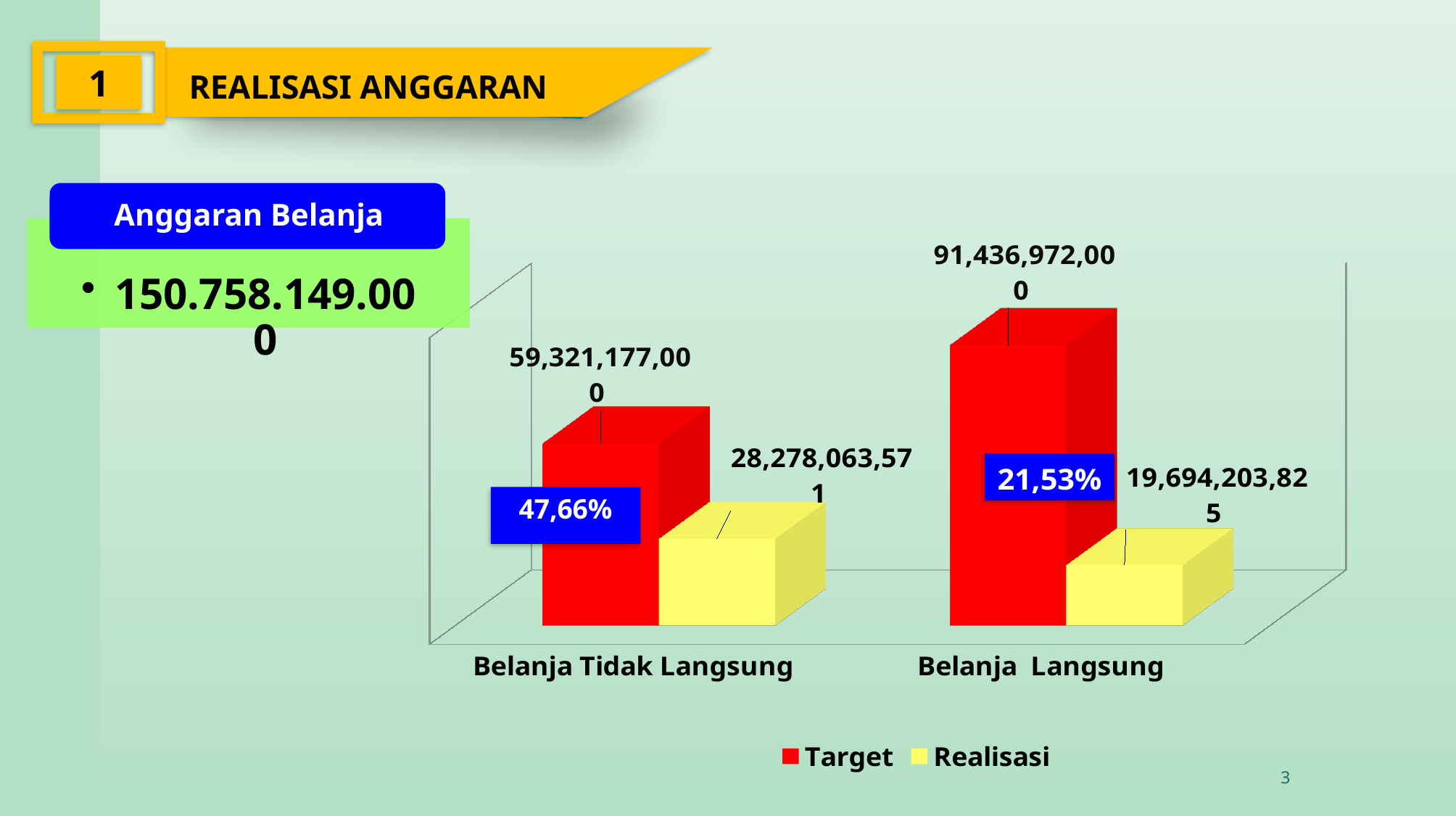
Which is larger: the Realisasi value for Belanja Tidak Langsung or the Realisasi value for Belanja Langsung? Belanja Tidak Langsung How many categories are shown on the x axis of the chart? 2 Which category has the highest Target value? Belanja Langsung How many series does the chart legend list? 2 What kind of chart is shown on the slide? Bar chart Which category has the lowest Realisasi value? Belanja Langsung What is the Realisasi value for Belanja Tidak Langsung? 28,278,063,571 What is the Target value for Belanja Tidak Langsung? 59,321,177,000 What is the Target value for Belanja Langsung? 91,436,972,000 Which series is shown in red in the chart legend? Target What is the Realisasi value for Belanja Langsung? 19,694,203,825 What is the difference between the Target and Realisasi values for Belanja Tidak Langsung? 31,043,113,429